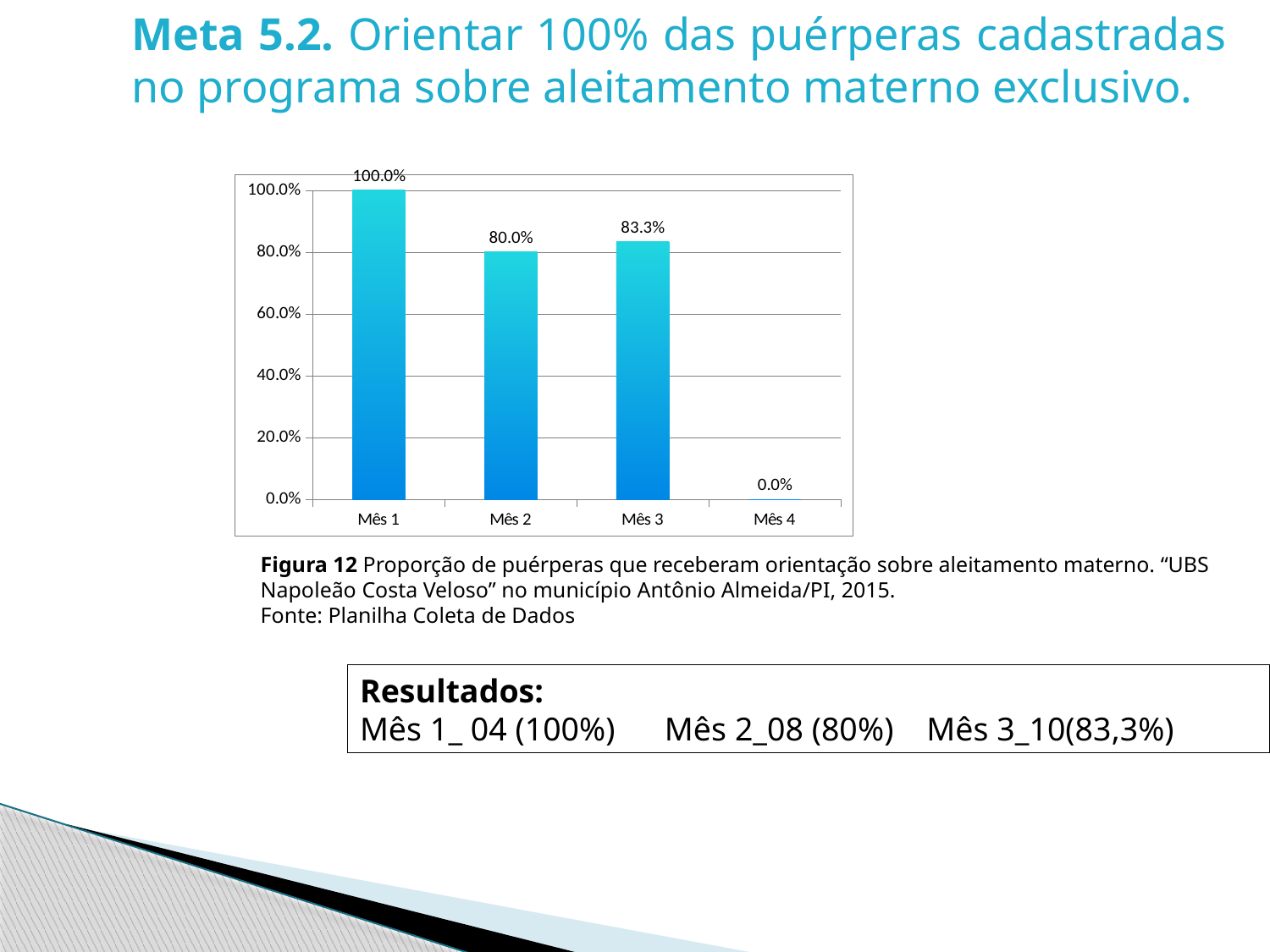
Which month has the highest value? Mês 1 What is the value for Mês 1? 100.0% What is the value for Mês 3? 83.3% What kind of chart is shown on the slide? Bar chart How many months are shown on the x axis? 4 Which is larger, the value for Mês 2 or Mês 3? Mês 3 What is the difference between the values for Mês 3 and Mês 2? 3.3% Which month has the lowest value? Mês 4 Is the value for Mês 2 greater or less than 60.0%? greater What is the value for Mês 4? 0.0% What is the value for Mês 2? 80.0% What is the difference between the values for Mês 1 and Mês 2? 20.0%